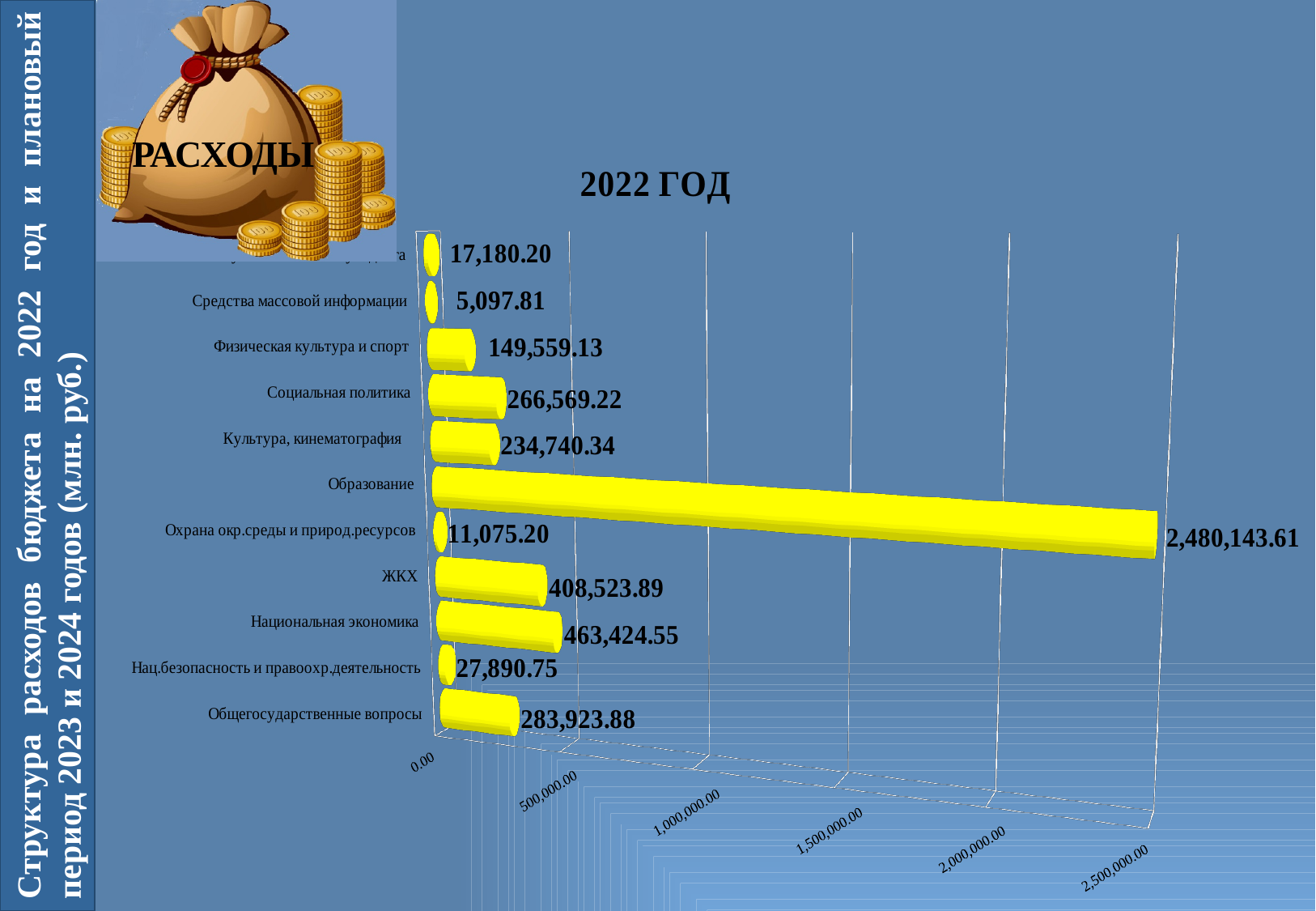
What is the value for Национальная экономика in the 2022 ГОД chart? 463,424.55 Which is larger in the 2022 ГОД chart: Социальная политика or Культура, кинематография? Социальная политика What is the value for Образование in the 2022 ГОД chart? 2,480,143.61 How many categories are shown in the 2022 ГОД chart? 11 What is the value for Общегосударственные вопросы in the 2022 ГОД chart? 283,923.88 Which category has the lowest value in the 2022 ГОД chart? Средства массовой информации What is the value for Средства массовой информации in the 2022 ГОД chart? 5,097.81 What kind of chart is shown on the slide? Bar chart Is the value for Образование in the 2022 ГОД chart greater or less than 2,000,000.00? greater What is the difference between the values for Национальная экономика and ЖКХ in the 2022 ГОД chart? 54,900.66 Which category has the highest value in the 2022 ГОД chart? Образование What is the value for ЖКХ in the 2022 ГОД chart? 408,523.89